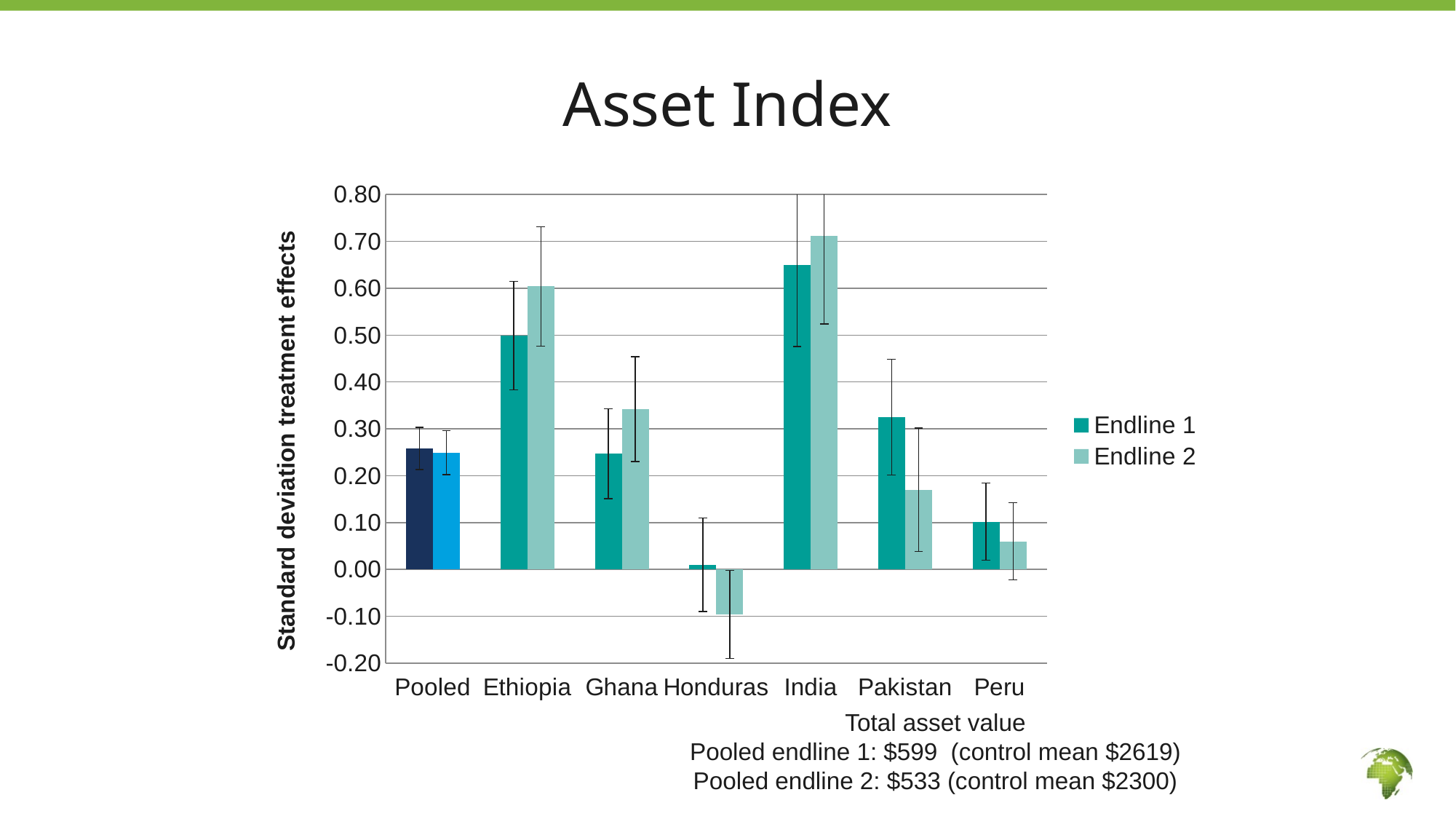
How many categories are shown on the x axis? 7 Which category has the lowest Endline 2 value? Honduras Is the Endline 1 value for Pakistan greater or less than 0.20? greater What kind of chart is shown on the slide? bar chart For Pakistan, which is larger: the Endline 1 value or the Endline 2 value? Endline 1 For Ethiopia, which is larger: the Endline 1 value or the Endline 2 value? Endline 2 What is the title of the vertical axis? Standard deviation treatment effects Which category has the highest Endline 2 value? India Is the Endline 2 value for Honduras greater or less than 0.00? less How many series does the legend list? 2 Is the Endline 2 value for Ethiopia greater or less than 0.50? greater Which category has the highest Endline 1 value? India